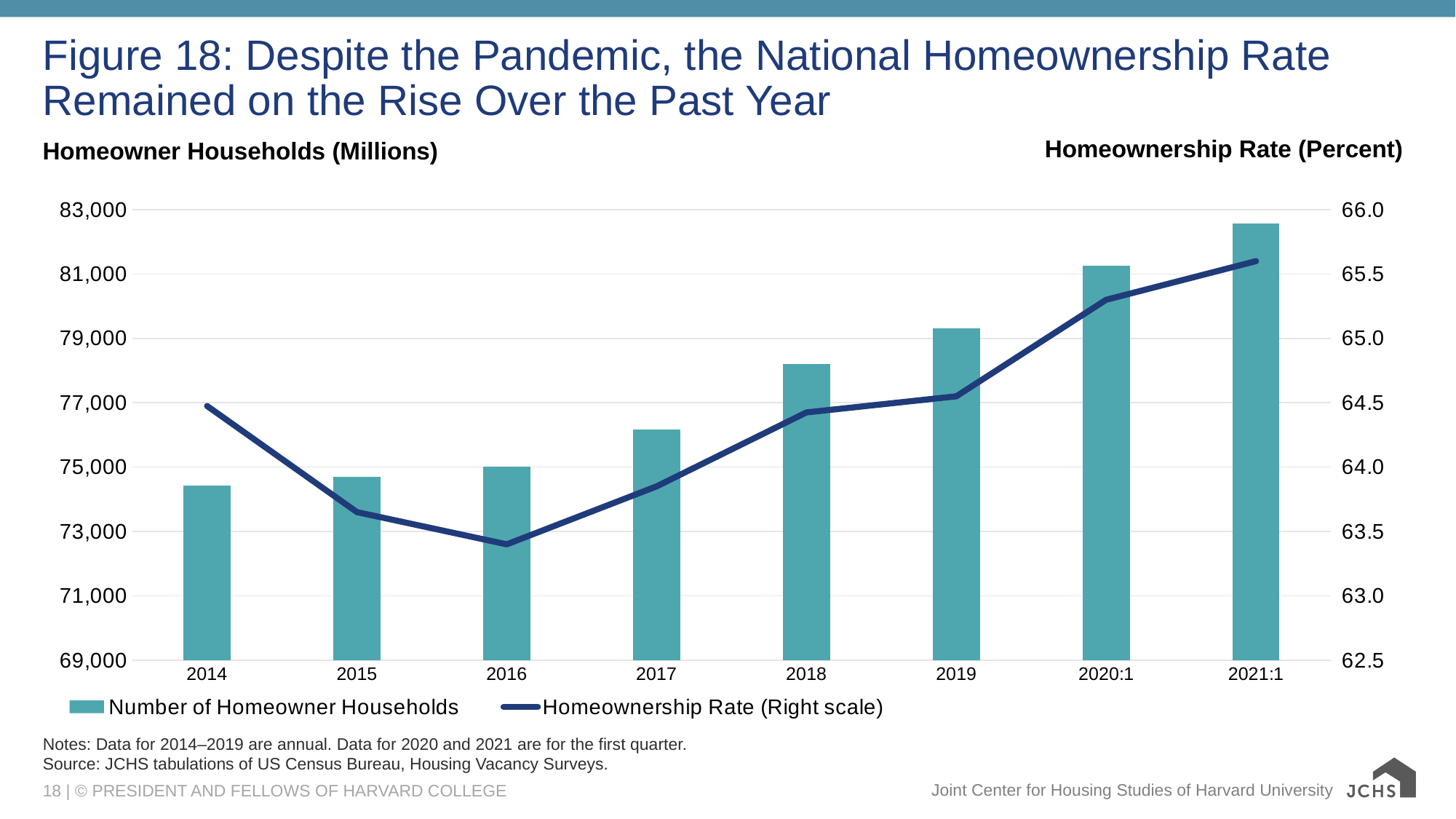
Which period has the highest number of homeowner households? 2021:1 How many series does the legend list? 2 In which period is the homeownership rate at its highest? 2021:1 Does the number of homeowner households rise or fall from 2014 to 2021:1? rise Is the number of homeowner households in 2017 greater or less than 77,000? less Which period has the lowest number of homeowner households? 2014 How many time periods are shown along the x axis? 8 In which period is the homeownership rate at its lowest? 2016 Is the number of homeowner households in 2018 greater or less than 77,000? greater What kind of chart is shown on the slide? A combined bar and line chart Is the homeownership rate in 2014 greater or less than 64.0? greater Which has more homeowner households, 2018 or 2019? 2019